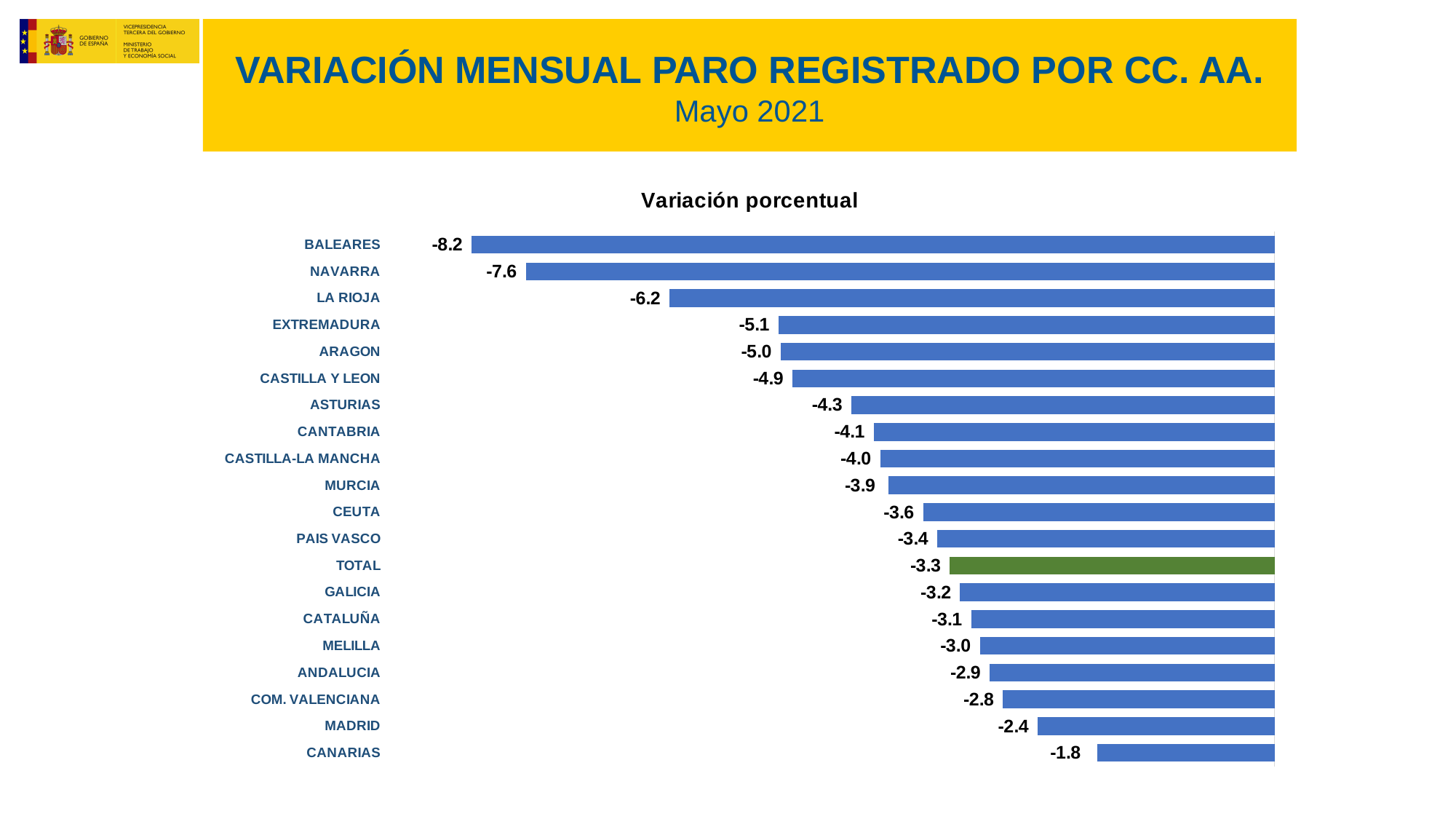
Which category has the highest (least negative) value? CANARIAS What is the value for TOTAL? -3.3 What kind of chart is shown on the slide? Bar chart What is the title of the chart? Variación porcentual What is the value for MADRID? -2.4 What is the difference between the values for NAVARRA and LA RIOJA? 1.4 How many categories are shown in the chart? 20 What is the value for BALEARES? -8.2 What is the value for CASTILLA-LA MANCHA? -4.0 Which bar is coloured green instead of blue? TOTAL Which has a larger (less negative) value, ASTURIAS or CEUTA? CEUTA Which category has the lowest (most negative) value? BALEARES